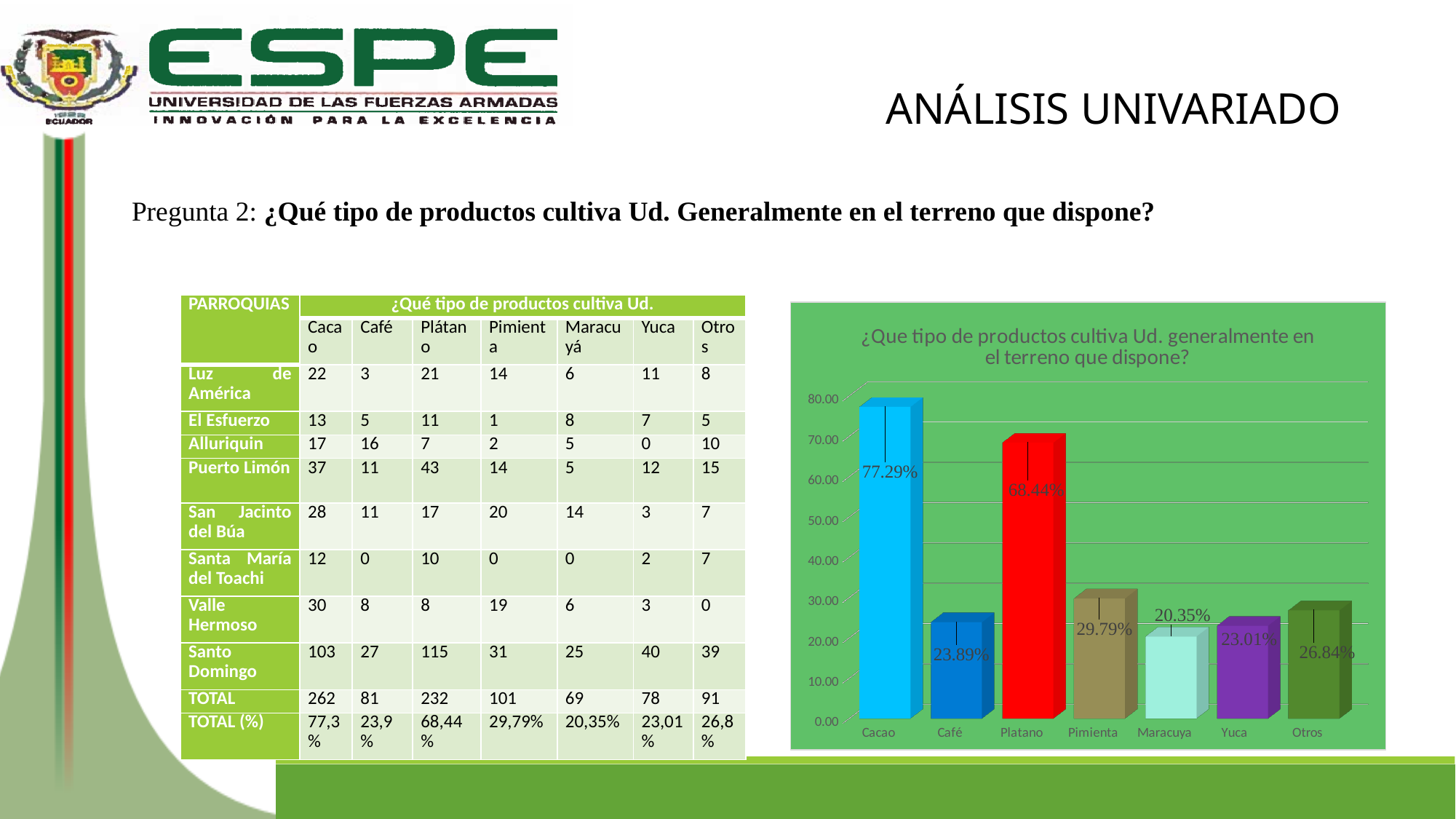
What is the value shown for Otros in the chart? 26.84% What is the value shown for Cacao in the chart? 77.29% What is the difference between the values for Cacao and Platano? 8.85% How many categories are shown on the x axis of the chart? 7 Which category has the highest value in the chart? Cacao What type of chart is shown on the slide? bar chart Is the value for Café greater or less than 30.00? less What is the value shown for Maracuya in the chart? 20.35% What is the value shown for Platano in the chart? 68.44% Which category has the lowest value in the chart? Maracuya What colour is the bar for Platano? red Which has a larger value, Pimienta or Otros? Pimienta